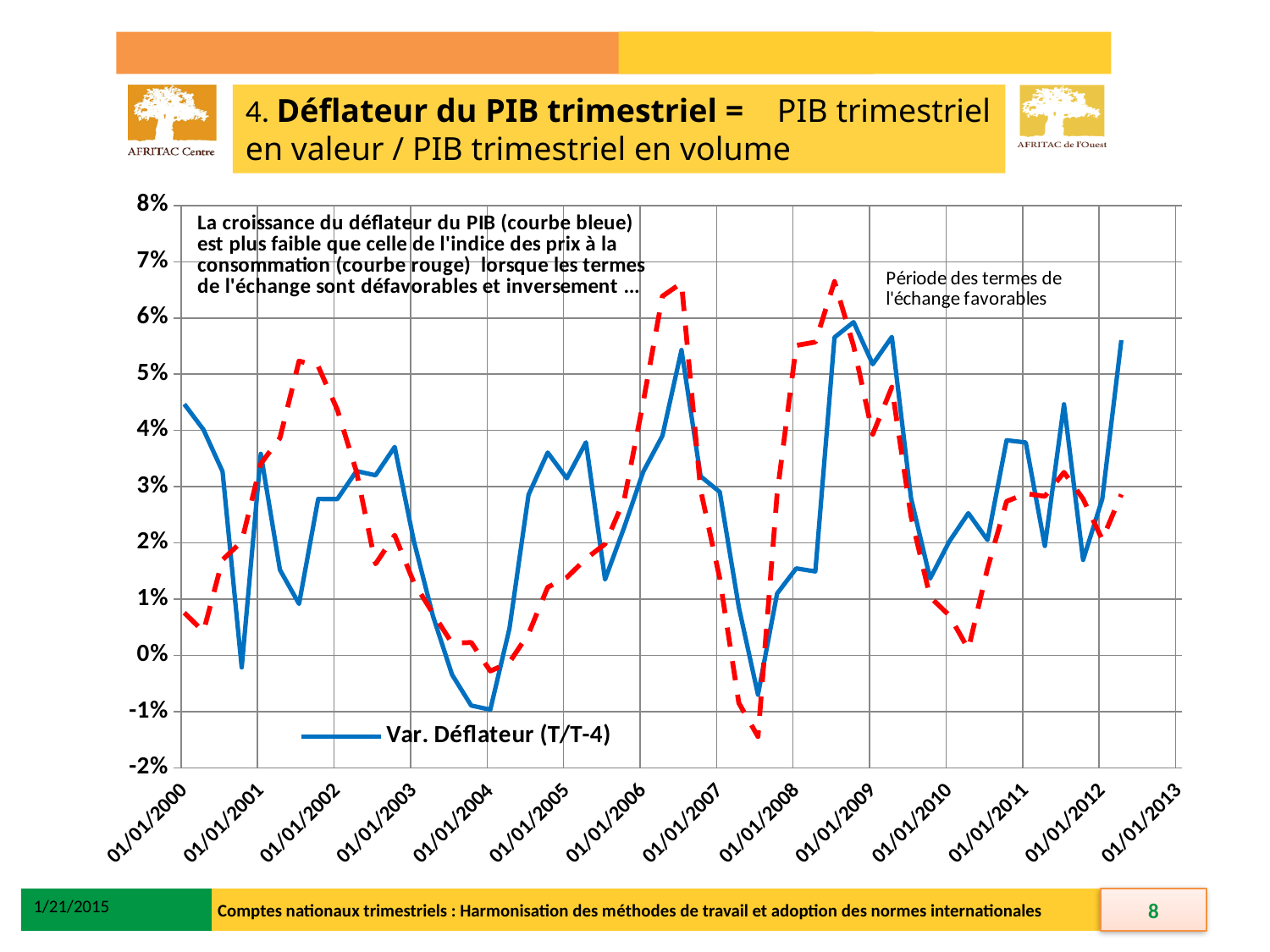
At 01/01/2006, which line is higher, the blue line or the red dashed line? the red dashed line How many date labels are shown on the x axis? 14 Is the value of the red dashed line at 01/01/2008 greater or less than 0%? greater What is the series name shown in the chart legend? Var. Déflateur (T/T-4) Is the value of the blue line (Var. Déflateur) at 01/01/2004 greater or less than 0%? less How many series does the chart legend list? 1 Is the value of the blue line (Var. Déflateur) at 01/01/2000 greater or less than 4%? greater According to the text box on the chart, which curve represents the consumer price index (indice des prix à la consommation)? the red curve (courbe rouge) At 01/01/2004, which line is lower, the blue line or the red dashed line? the blue line What kind of chart is shown on the slide? line chart